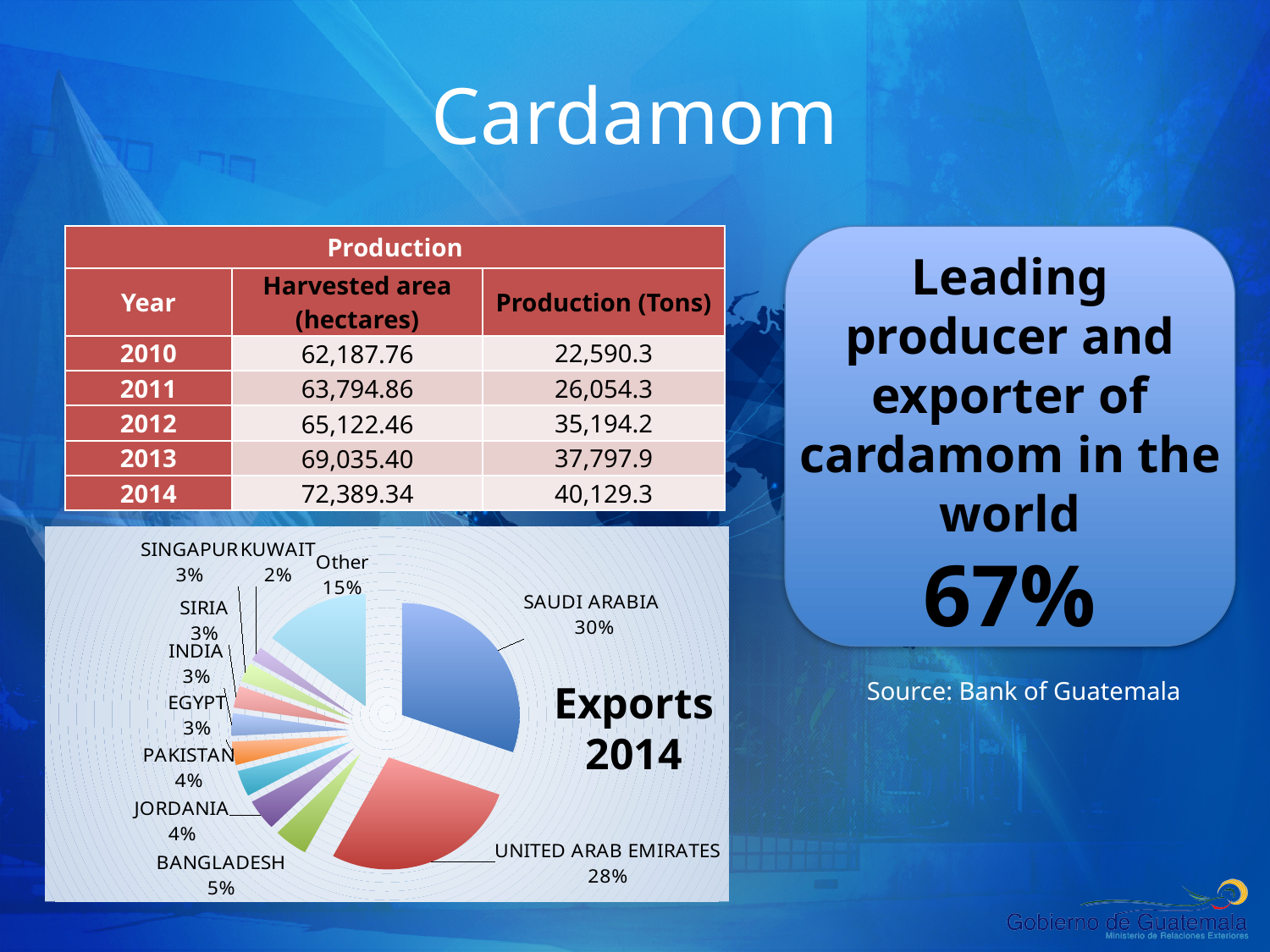
What share of 2014 exports went to the United Arab Emirates? 28% What share of 2014 exports went to Saudi Arabia? 30% Which destination has the largest share of 2014 exports? Saudi Arabia What is the title of the pie chart? Exports 2014 Which has a larger share of 2014 exports, Bangladesh or Pakistan? Bangladesh Which destination has the smallest share of 2014 exports? Kuwait How many slices does the Exports 2014 pie chart have? 11 What kind of chart is shown on the slide? pie chart What share of 2014 exports went to Kuwait? 2% What share of 2014 exports went to Bangladesh? 5% What share of 2014 exports is labelled Other? 15% What is the difference in percentage points between the Saudi Arabia and United Arab Emirates shares? 2 percentage points